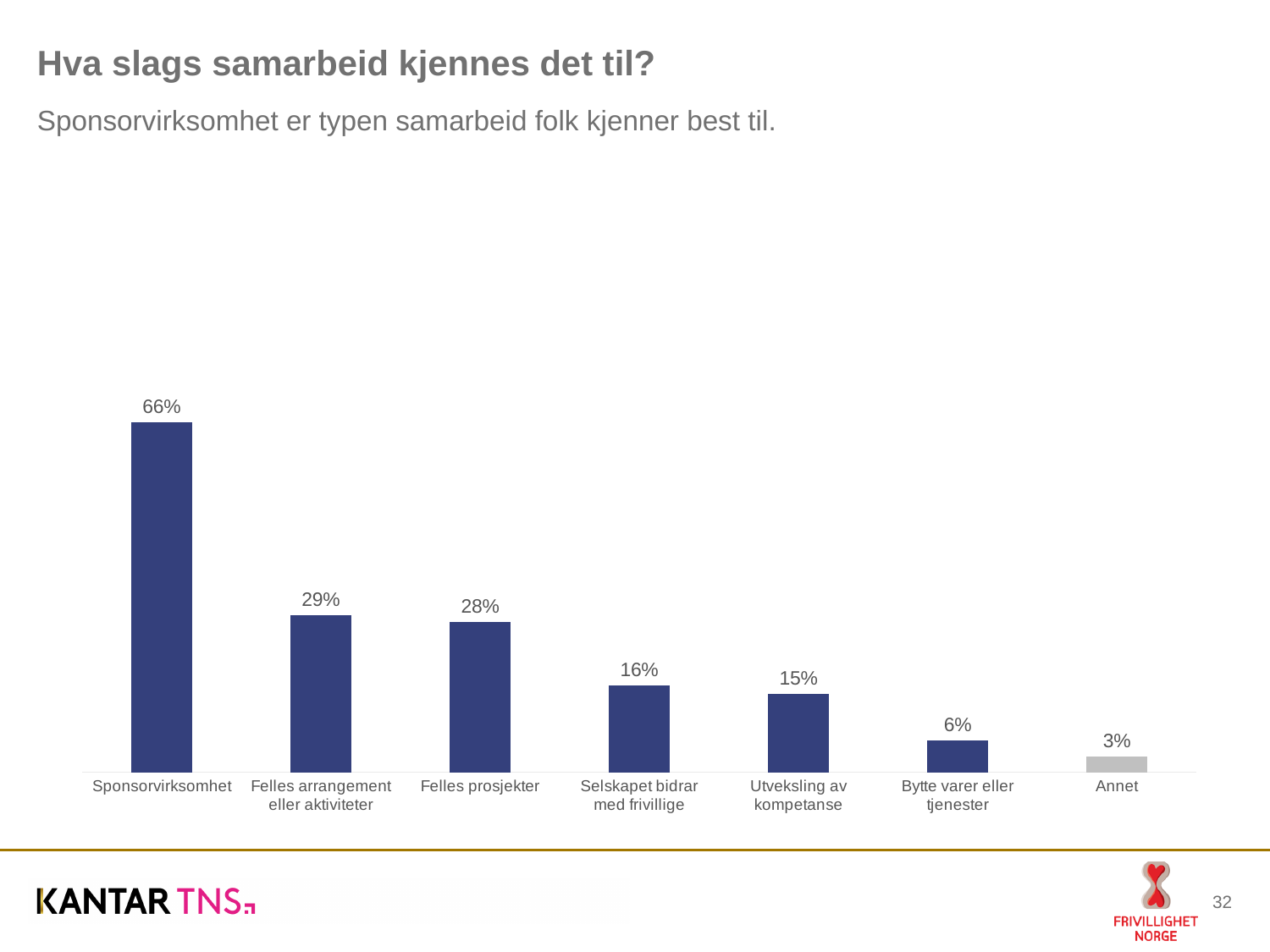
Which category has the highest value? Sponsorvirksomhet What kind of chart is shown on the slide? Bar chart How many categories are shown in the chart? 7 What is the value for Sponsorvirksomhet? 66% What is the value for Utveksling av kompetanse? 15% Which category has the lowest value? Annet What is the difference between Sponsorvirksomhet and Felles arrangement eller aktiviteter? 37% Which is larger, Felles arrangement eller aktiviteter or Felles prosjekter? Felles arrangement eller aktiviteter Do the values rise or fall from left to right along the x axis? Fall What is the difference between Selskapet bidrar med frivillige and Bytte varer eller tjenester? 10% What is the value for Felles prosjekter? 28% What is the value for Annet? 3%